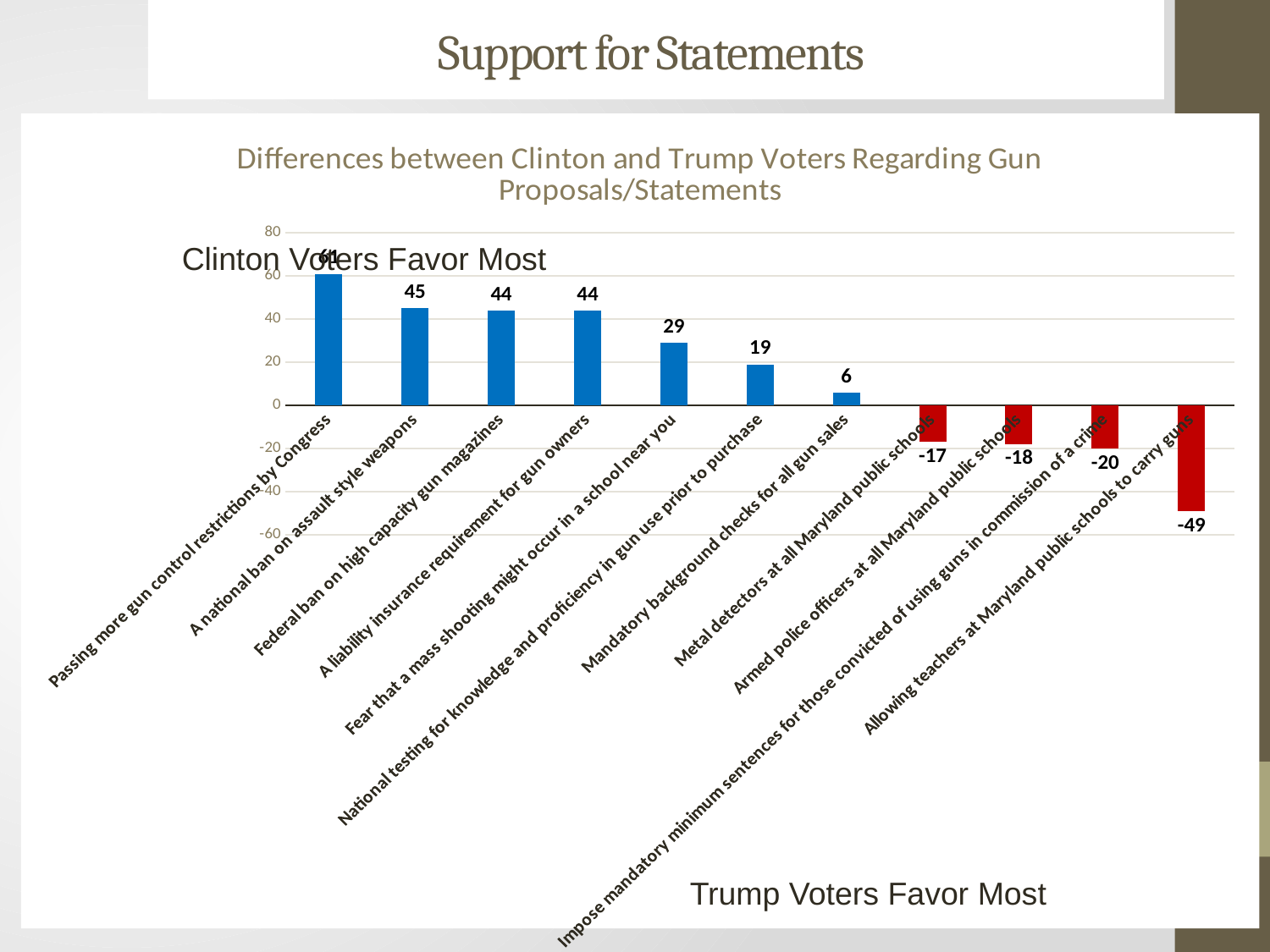
Which statement has the lowest value in the chart? Allowing teachers at Maryland public schools to carry guns Which has the larger value: "National testing for knowledge and proficiency in gun use prior to purchase" or "Mandatory background checks for all gun sales"? National testing for knowledge and proficiency in gun use prior to purchase What is the difference between the values for "A national ban on assault style weapons" and "Fear that a mass shooting might occur in a school near you"? 16 What is the value for "Mandatory background checks for all gun sales"? 6 What is the value for "A national ban on assault style weapons"? 45 Do the values rise or fall moving from left to right along the x axis? fall What is the value for "Armed police officers at all Maryland public schools"? -18 What is the title of the chart? Differences between Clinton and Trump Voters Regarding Gun Proposals/Statements Which statement has the highest value in the chart? Passing more gun control restrictions by Congress What is the value for "Allowing teachers at Maryland public schools to carry guns"? -49 What kind of chart is shown on the slide? bar chart How many categories (statements) are plotted in the chart? 11